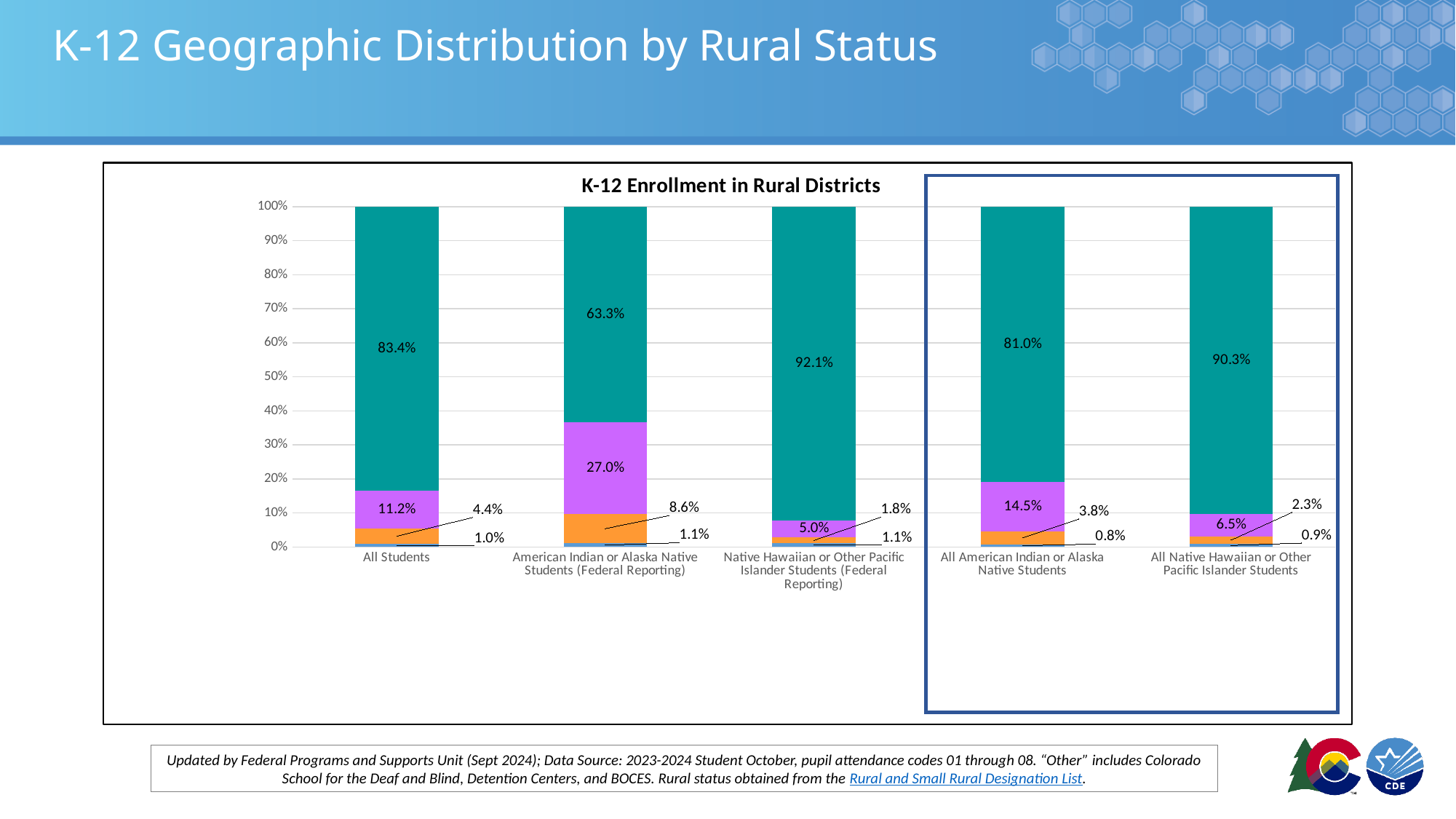
What is the difference between the purple segment for American Indian or Alaska Native Students (Federal Reporting) and the purple segment for All Students? 15.8% Which category has the smallest teal segment? American Indian or Alaska Native Students (Federal Reporting) What kind of chart is shown on the slide? Stacked bar chart How many categories (bars) are shown on the x axis? 5 What is the value of the smallest (bottom) segment for Native Hawaiian or Other Pacific Islander Students (Federal Reporting)? 1.1% What is the value of the teal segment for All Native Hawaiian or Other Pacific Islander Students? 90.3% Which is larger: the orange segment for All Students or the orange segment for All Native Hawaiian or Other Pacific Islander Students? All Students What is the value of the teal (largest) segment for All Students? 83.4% What is the value of the orange segment for All American Indian or Alaska Native Students? 3.8% What is the value of the purple segment for American Indian or Alaska Native Students (Federal Reporting)? 27.0% Which category has the largest teal segment? Native Hawaiian or Other Pacific Islander Students (Federal Reporting) What is the title of the chart? K-12 Enrollment in Rural Districts